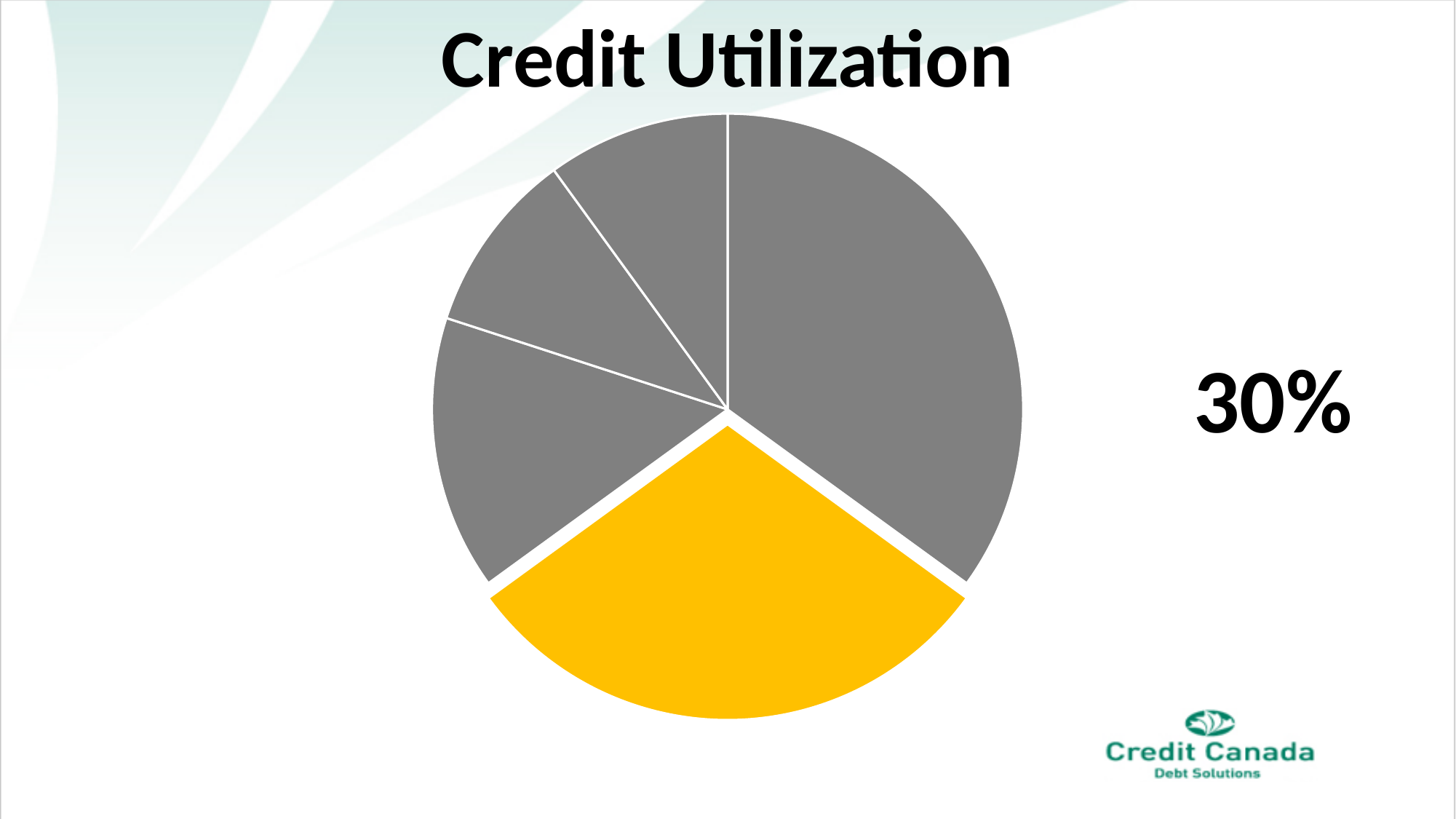
What percentage value is printed beside the pie chart? 30% Does the yellow slice represent more or less than half of the pie? less How many slices does the pie chart have? 5 What is the title of the chart? Credit Utilization What kind of chart is shown on the slide? pie chart What colour is the slice that is pulled out from the pie? yellow Does the large gray slice on the right side of the pie represent more or less than half of the pie? less What share of the pie does the highlighted yellow slice represent, according to the label on the slide? 30% How many of the pie slices are coloured gray? 4